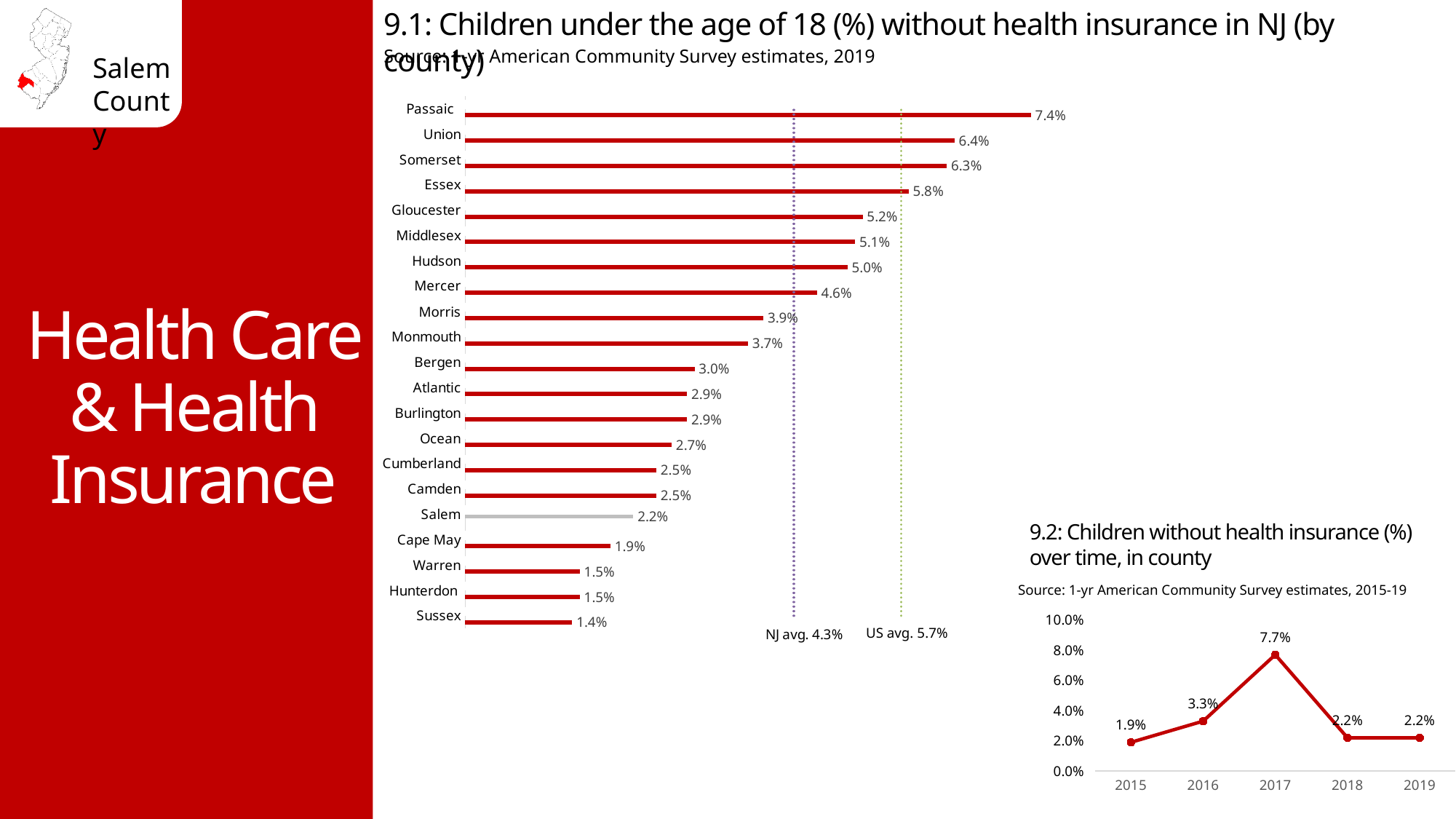
In chart 9.1, what NJ average is marked by the dotted line? 4.3% In chart 9.1, how many counties are shown? 21 In chart 9.2, what is the difference between the values for 2017 and 2018? 5.5% In chart 9.1 (children under 18 without health insurance by county), what is the value for Salem? 2.2% In chart 9.1, which county has the highest percentage of children without health insurance? Passaic What kind of chart is chart 9.2 (children without health insurance over time)? Line chart In chart 9.1, which county has the lowest percentage of children without health insurance? Sussex In chart 9.1, what is the value for Hudson? 5.0% In chart 9.1, what is the difference between the values for Passaic and Sussex? 6.0% In chart 9.2, what is the value for 2017? 7.7% In chart 9.2, which year has the highest value? 2017 In chart 9.1, which county has a larger value, Gloucester or Mercer? Gloucester